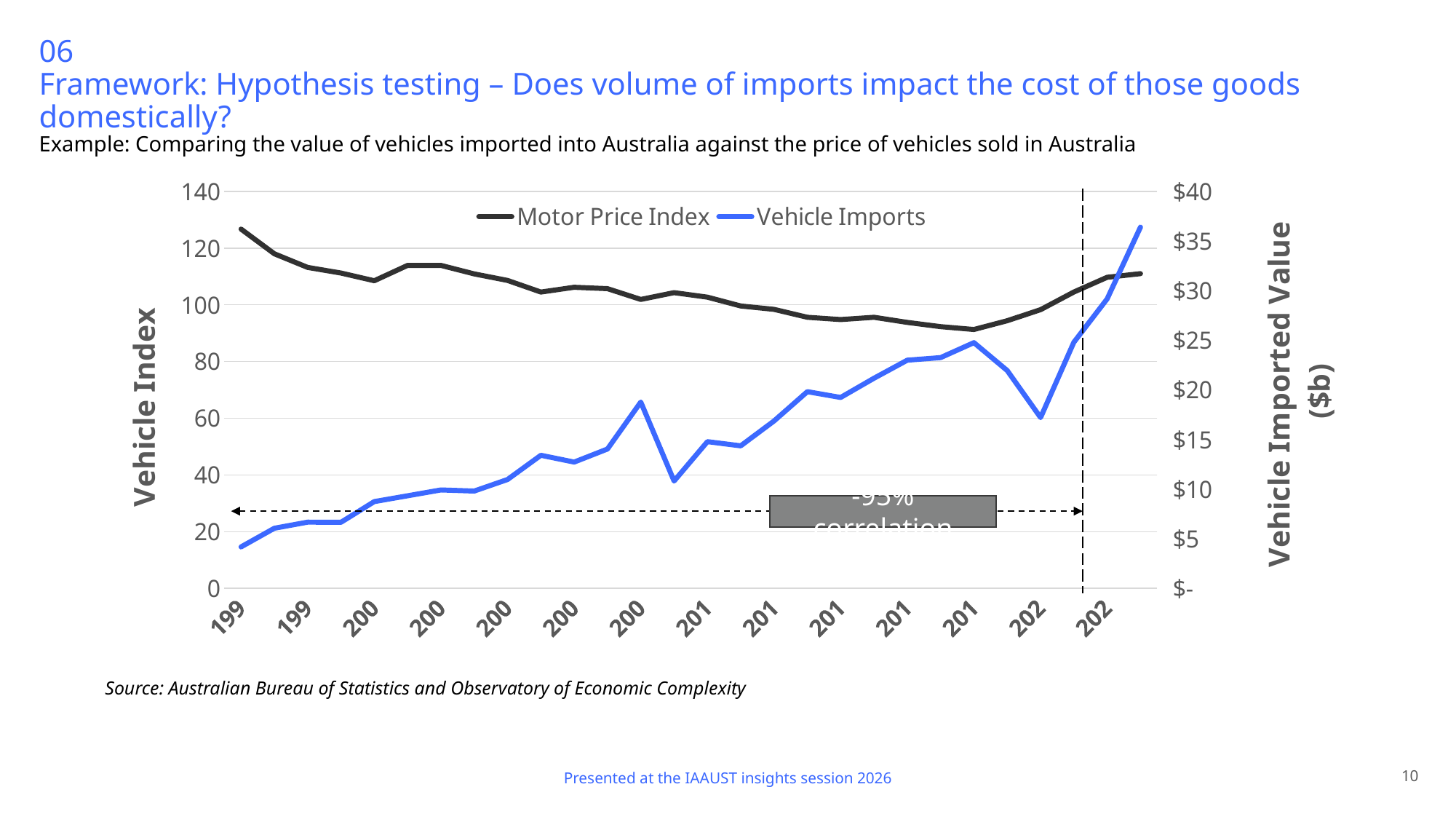
Is the Motor Price Index at the last point of the series greater or less than 100? greater Does the Vehicle Imports series generally rise or fall from left to right across the chart? Rise Is the Vehicle Imports value at the last point of the series greater or less than $30? greater Is the Motor Price Index at the first point of the series greater or less than 120? greater What are the two series named in the chart's legend? Motor Price Index and Vehicle Imports At which end of the chart, the first point or the last point, does the Vehicle Imports series reach its highest value? The last point What kind of chart is shown on the slide? Line chart How many series does the chart's legend list? 2 At which end of the chart, the first point or the last point, does the Motor Price Index series reach its highest value? The first point What is the title of the right-hand vertical axis of the chart? Vehicle Imported Value ($b)